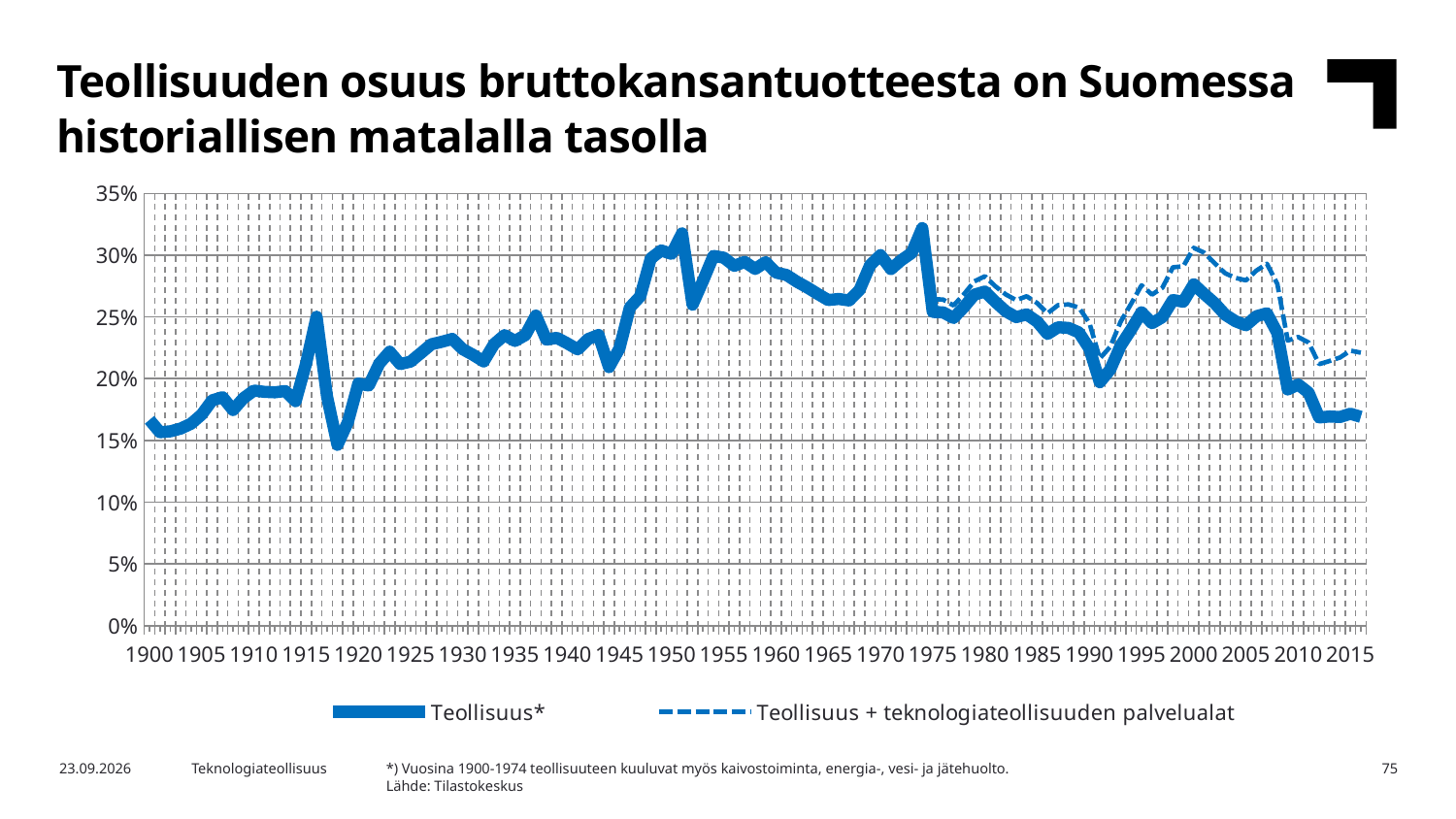
In 2015, which series has the higher value: Teollisuus* or Teollisuus + teknologiateollisuuden palvelualat? Teollisuus + teknologiateollisuuden palvelualat Is the value for Teollisuus* in 1950 greater or less than 25%? greater Does the Teollisuus* series rise or fall between 2005 and 2015? fall Is the value for Teollisuus + teknologiateollisuuden palvelualat in 2015 greater or less than 20%? greater Is the value for Teollisuus* in 2015 greater or less than 20%? less Which is larger for Teollisuus*: the value in 1950 or the value in 2015? 1950 What are the two series named in the legend? Teollisuus* and Teollisuus + teknologiateollisuuden palvelualat Which series is drawn with a dashed line? Teollisuus + teknologiateollisuuden palvelualat How many series does the legend list? 2 What kind of chart is shown on the slide? line chart